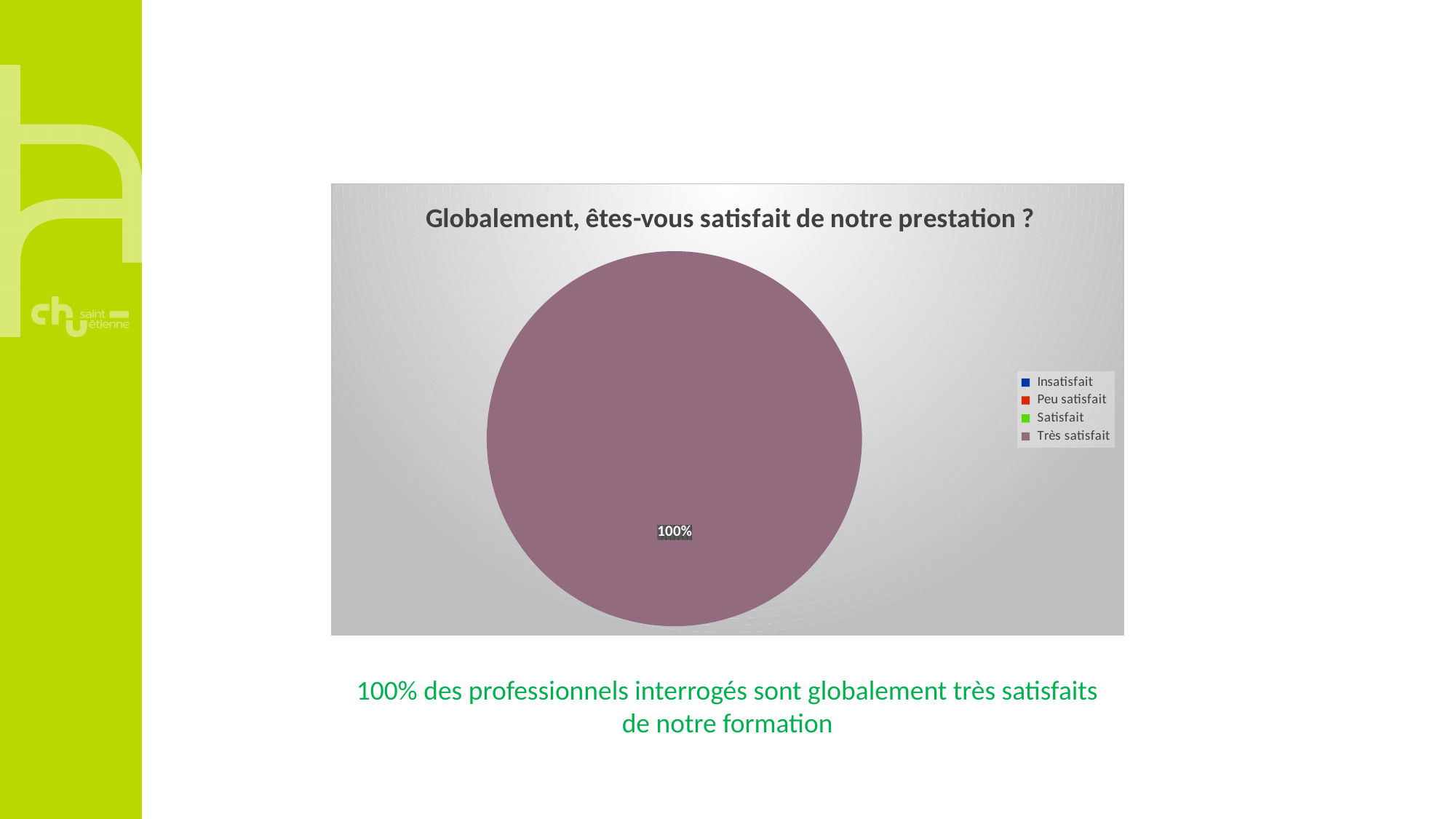
Which is larger, the share for "Très satisfait" or the share for "Satisfait"? Très satisfait How many entries does the chart's legend list? 4 What share of the pie does "Très satisfait" represent? 100% Is the share for "Très satisfait" greater or less than 50%? greater What is the title of the chart? Globalement, êtes-vous satisfait de notre prestation ? Which legend entry is shown in the mauve/purple colour that fills the pie? Très satisfait Which category makes up the largest share of the pie? Très satisfait What is the value shown on the data label of the pie? 100% What kind of chart is shown on the slide? pie chart